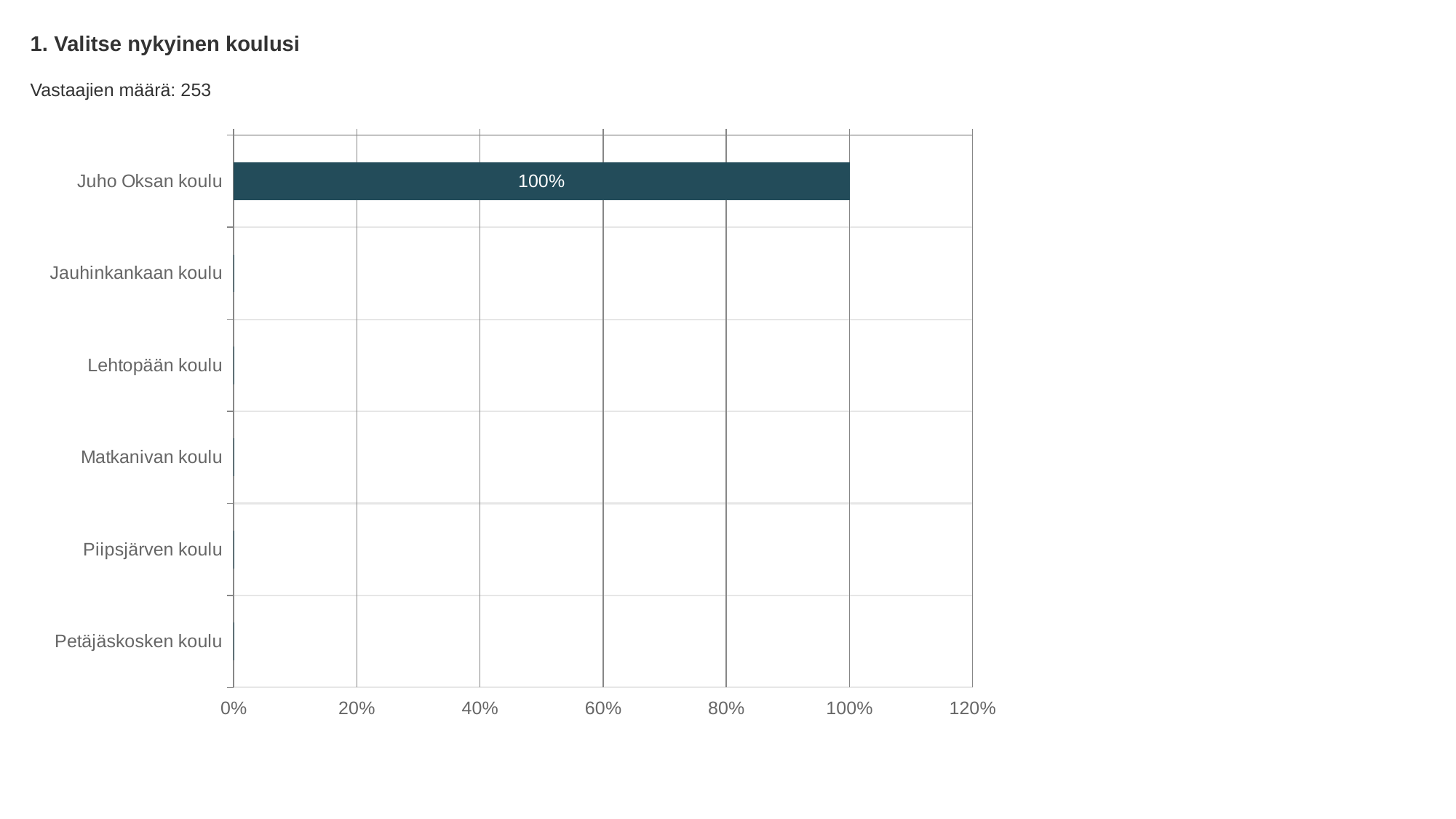
How many schools are listed on the chart? 6 What is the value for Juho Oksan koulu? 100% How many respondents (Vastaajien määrä) does the slide report? 253 Which is larger, the value for Matkanivan koulu or the value for Juho Oksan koulu? Juho Oksan koulu Which school has the highest value? Juho Oksan koulu Is the value for Jauhinkankaan koulu greater or less than 20%? less Is the value for Petäjäskosken koulu greater or less than 20%? less What is the title of the chart? 1. Valitse nykyinen koulusi What is the highest value shown on the x axis? 120% Is the value for Juho Oksan koulu greater or less than 80%? greater Which is larger, the value for Juho Oksan koulu or the value for Lehtopään koulu? Juho Oksan koulu What kind of chart is shown on the slide? Bar chart